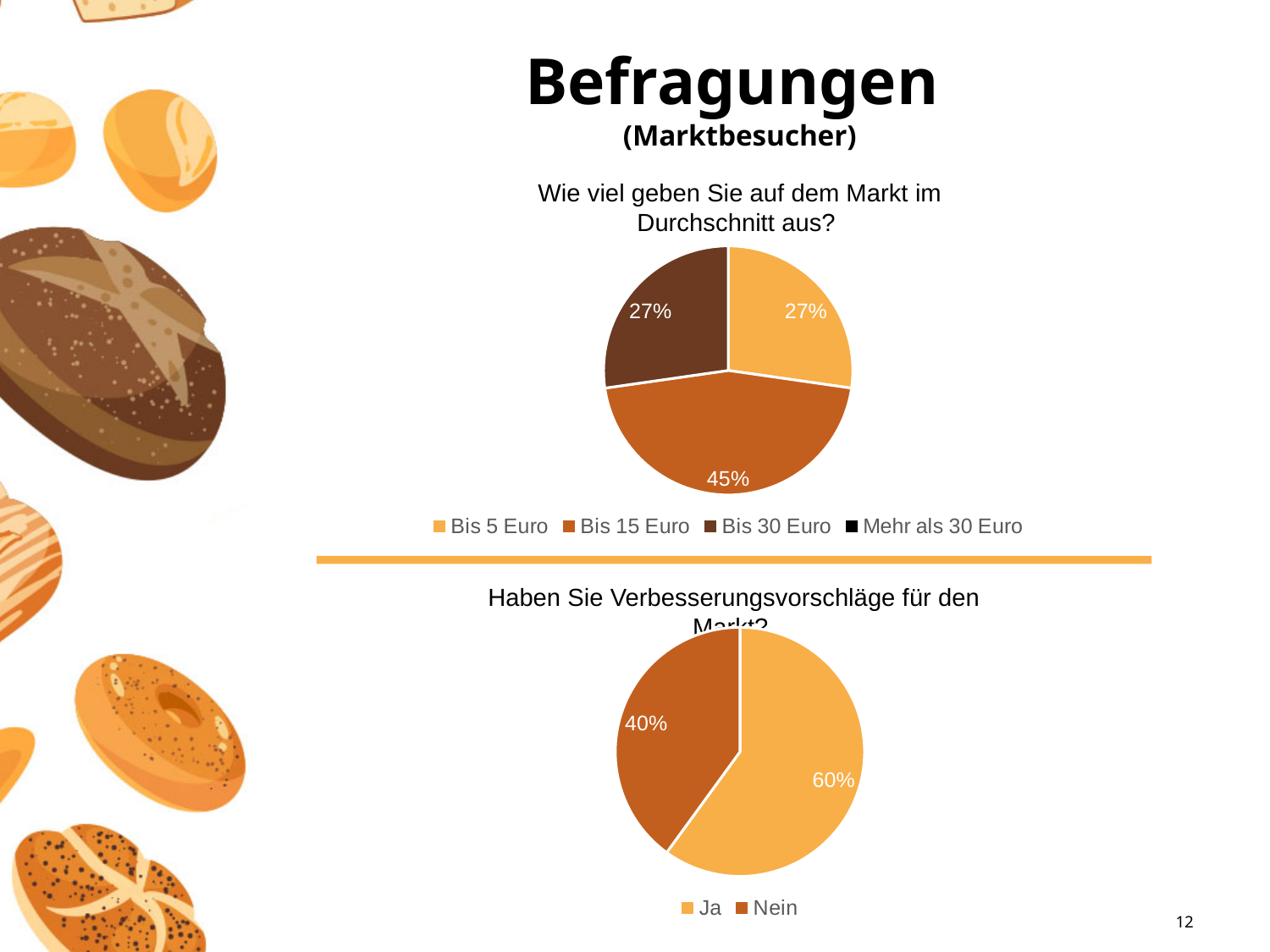
In the top chart 'Wie viel geben Sie auf dem Markt im Durchschnitt aus?', which category has the largest share? Bis 15 Euro In the top chart 'Wie viel geben Sie auf dem Markt im Durchschnitt aus?', what share of respondents spend 'Bis 30 Euro'? 27% In the bottom chart 'Haben Sie Verbesserungsvorschläge für den Markt?', what is the difference in percentage points between 'Ja' and 'Nein'? 20 In the bottom chart 'Haben Sie Verbesserungsvorschläge für den Markt?', what share of respondents answered 'Ja'? 60% In the bottom chart 'Haben Sie Verbesserungsvorschläge für den Markt?', how many entries does the legend list? 2 In the bottom chart 'Haben Sie Verbesserungsvorschläge für den Markt?', which answer has the larger share, 'Ja' or 'Nein'? Ja What type of chart is the top chart 'Wie viel geben Sie auf dem Markt im Durchschnitt aus?'? Pie chart In the top chart 'Wie viel geben Sie auf dem Markt im Durchschnitt aus?', what share of respondents spend 'Bis 5 Euro'? 27% In the bottom chart 'Haben Sie Verbesserungsvorschläge für den Markt?', what share of respondents answered 'Nein'? 40% In the top chart 'Wie viel geben Sie auf dem Markt im Durchschnitt aus?', what is the difference in percentage points between 'Bis 15 Euro' and 'Bis 5 Euro'? 18 In the top chart 'Wie viel geben Sie auf dem Markt im Durchschnitt aus?', what share of respondents spend 'Bis 15 Euro'? 45% In the top chart 'Wie viel geben Sie auf dem Markt im Durchschnitt aus?', how many entries does the legend list? 4